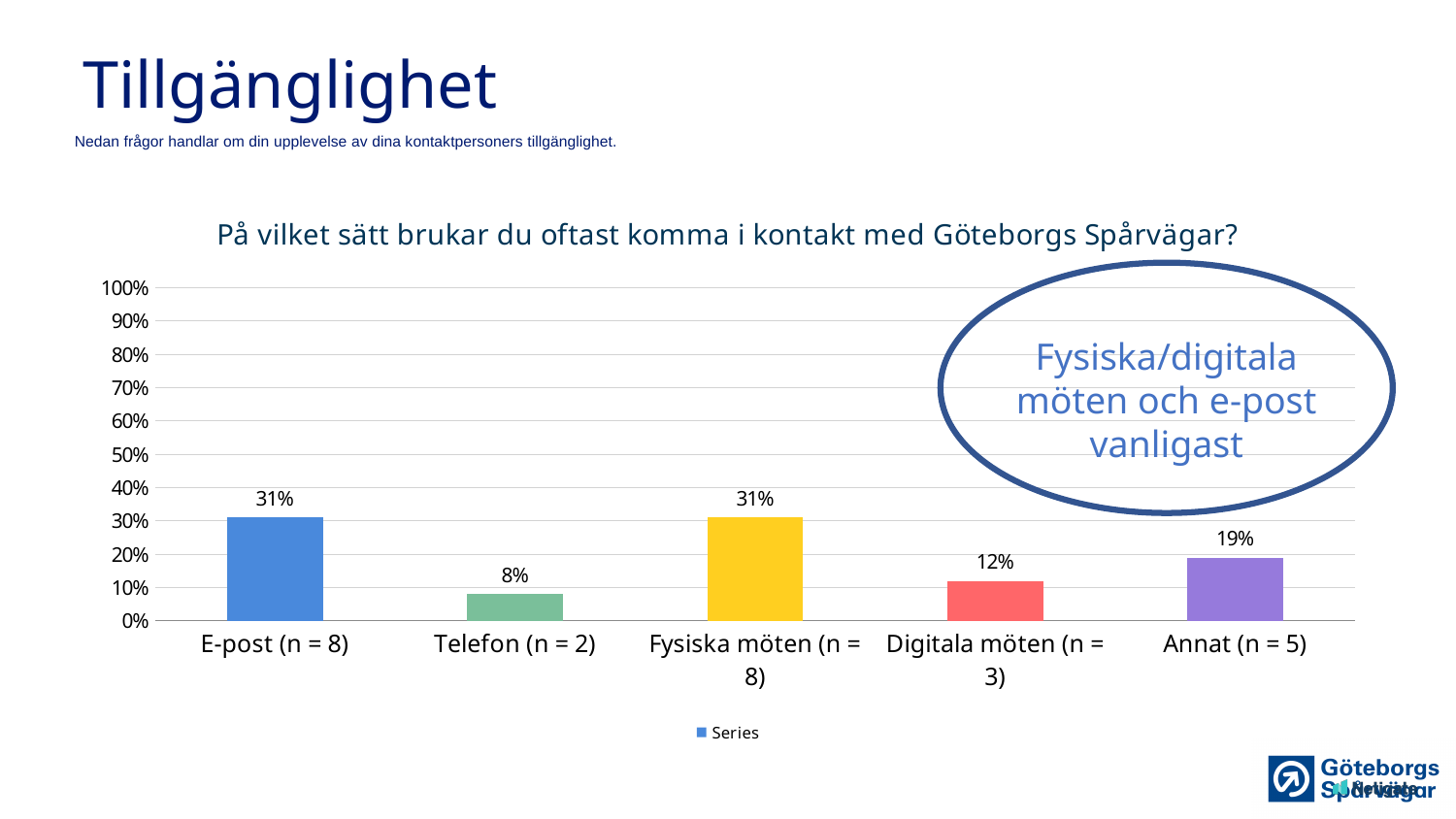
How many categories are shown on the x axis? 5 What is the value for E-post (n = 8)? 31% What is the value for Annat (n = 5)? 19% What kind of chart is shown on the slide? bar chart What is the difference between the values for Annat (n = 5) and Digitala möten (n = 3)? 7% Which category has the lowest value? Telefon (n = 2) What is the difference between the values for Fysiska möten (n = 8) and Telefon (n = 2)? 23% What is the value for Digitala möten (n = 3)? 12% Which is larger, the value for Annat (n = 5) or the value for Digitala möten (n = 3)? Annat (n = 5) What is the title of the chart? På vilket sätt brukar du oftast komma i kontakt med Göteborgs Spårvägar? Is the value for E-post (n = 8) greater or less than 50%? less What is the value for Telefon (n = 2)? 8%